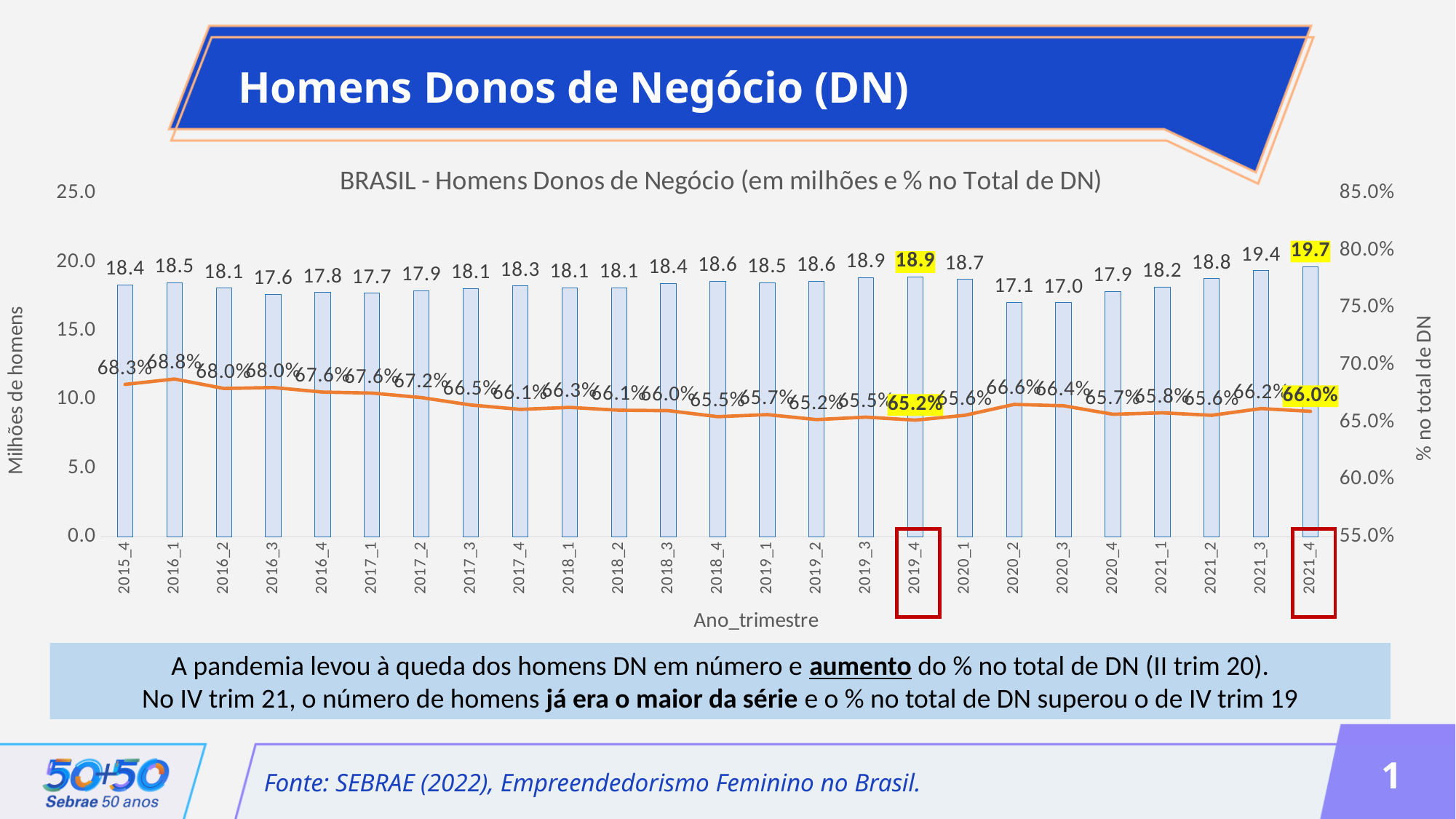
What is the value of the bar for 2021_4 (millions of men)? 19.7 How many quarters (categories) are plotted on the x axis? 25 What is the difference in millions between the bars for 2021_4 and 2019_4? 0.8 What percentage of total DN is shown for 2021_4? 66.0% Which is larger, the bar for 2020_2 or the bar for 2021_1? 2021_1 Which quarter has the highest percentage of men in the total DN on the line? 2016_1 Which quarter has the lowest number of men business owners (shortest bar)? 2020_3 What is the value of the bar for 2020_3? 17.0 Which quarter has the highest number of men business owners (tallest bar)? 2021_4 What kind of chart is this? Combined bar and line chart What is the title of the x axis? Ano_trimestre What percentage of total DN is shown for 2019_4? 65.2%